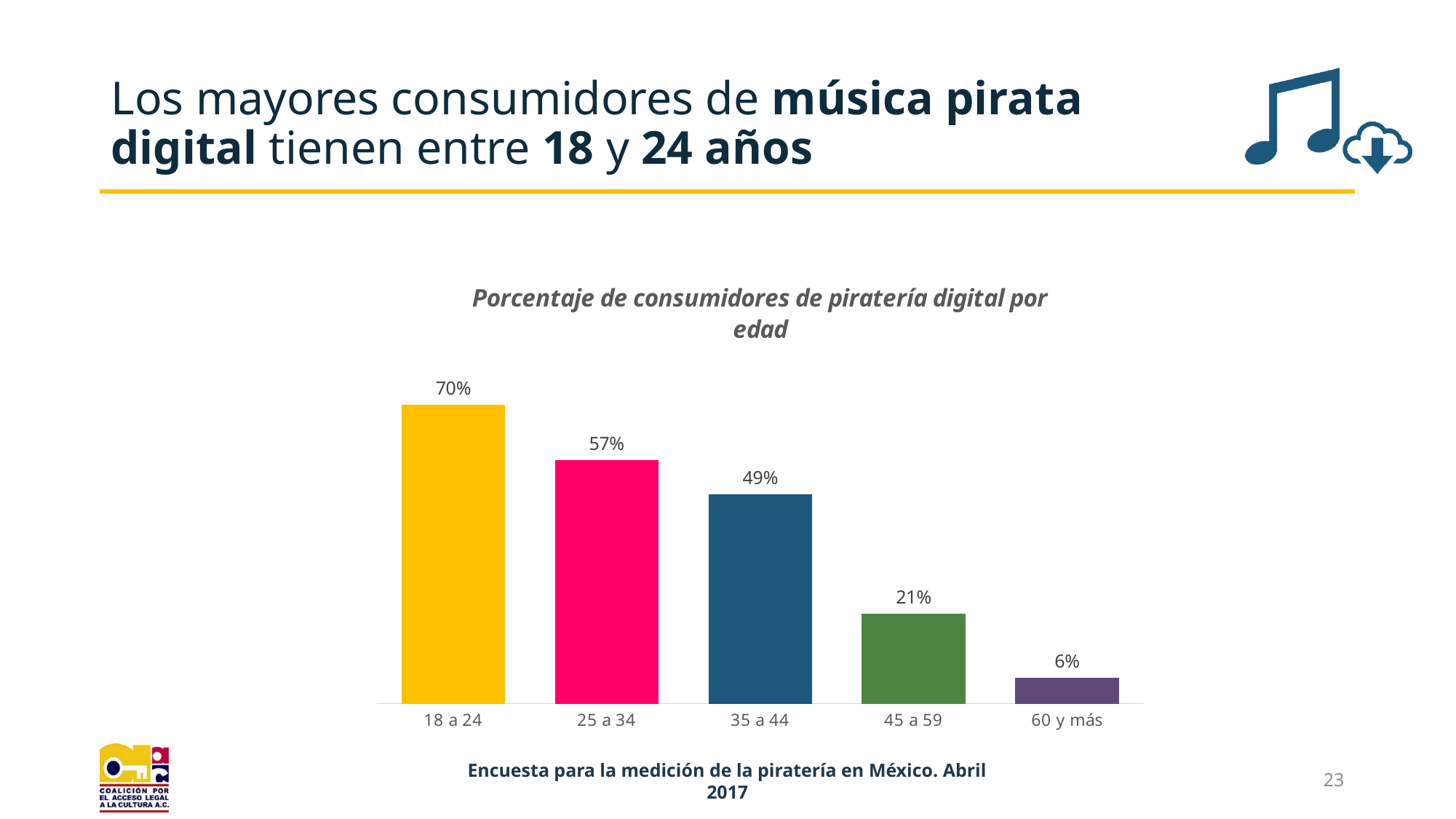
What is the difference between the values for 18 a 24 and 25 a 34? 13% What is the title of the chart? Porcentaje de consumidores de piratería digital por edad Do the values rise or fall as age increases along the x axis? Fall What is the value for the 18 a 24 age group? 70% What is the value for the 60 y más age group? 6% Which is larger, the value for 25 a 34 or the value for 35 a 44? 25 a 34 Which age group has the lowest percentage of digital piracy consumers? 60 y más What kind of chart is shown on the slide? Bar chart Which age group has the highest percentage of digital piracy consumers? 18 a 24 What is the difference between the values for 45 a 59 and 60 y más? 15% How many age groups are shown in the chart? 5 What is the value for the 35 a 44 age group? 49%